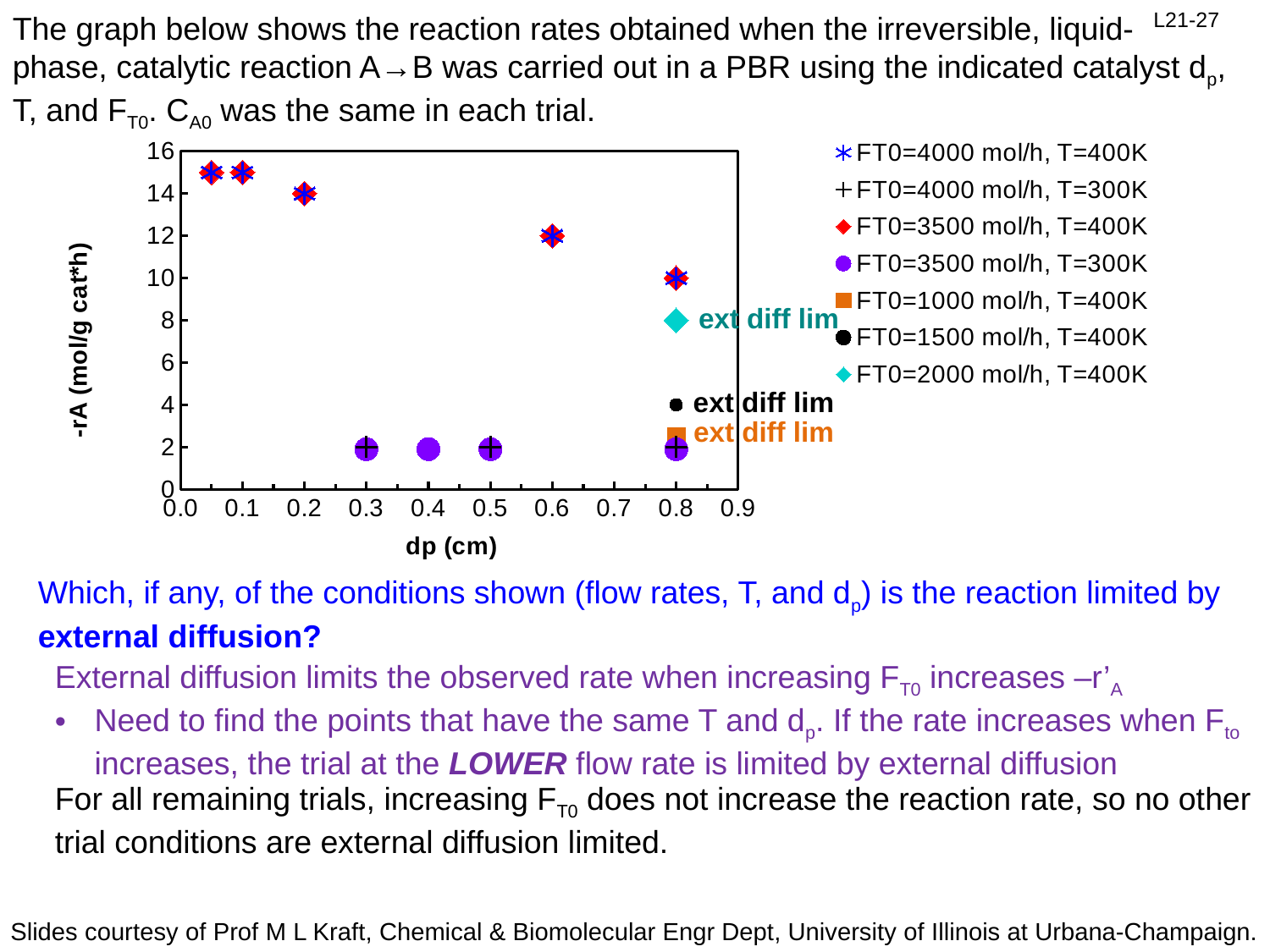
How many series does the chart legend list? 7 At dp = 0.8 cm, which has the higher reaction rate: FT0=4000 mol/h, T=400K or FT0=2000 mol/h, T=400K? FT0=4000 mol/h, T=400K Is the reaction rate for FT0=4000 mol/h, T=400K at dp = 0.1 cm greater or less than 14? greater Is the reaction rate for FT0=3500 mol/h, T=300K at dp = 0.4 cm greater or less than 4? less What is the reaction rate -rA for FT0=1500 mol/h, T=400K at dp = 0.8 cm? 4 What is the reaction rate -rA for FT0=2000 mol/h, T=400K at dp = 0.8 cm? 8 What is the reaction rate -rA for FT0=4000 mol/h, T=400K at dp = 0.6 cm? 12 What kind of chart is shown on the slide? scatter chart At which dp value is the reaction rate for FT0=4000 mol/h, T=400K lowest? 0.8 For the FT0=4000 mol/h, T=400K series, does the reaction rate rise or fall as dp increases? fall What is the label of the y axis of the chart? -rA (mol/g cat*h) What is the reaction rate -rA for FT0=4000 mol/h, T=400K at dp = 0.2 cm? 14